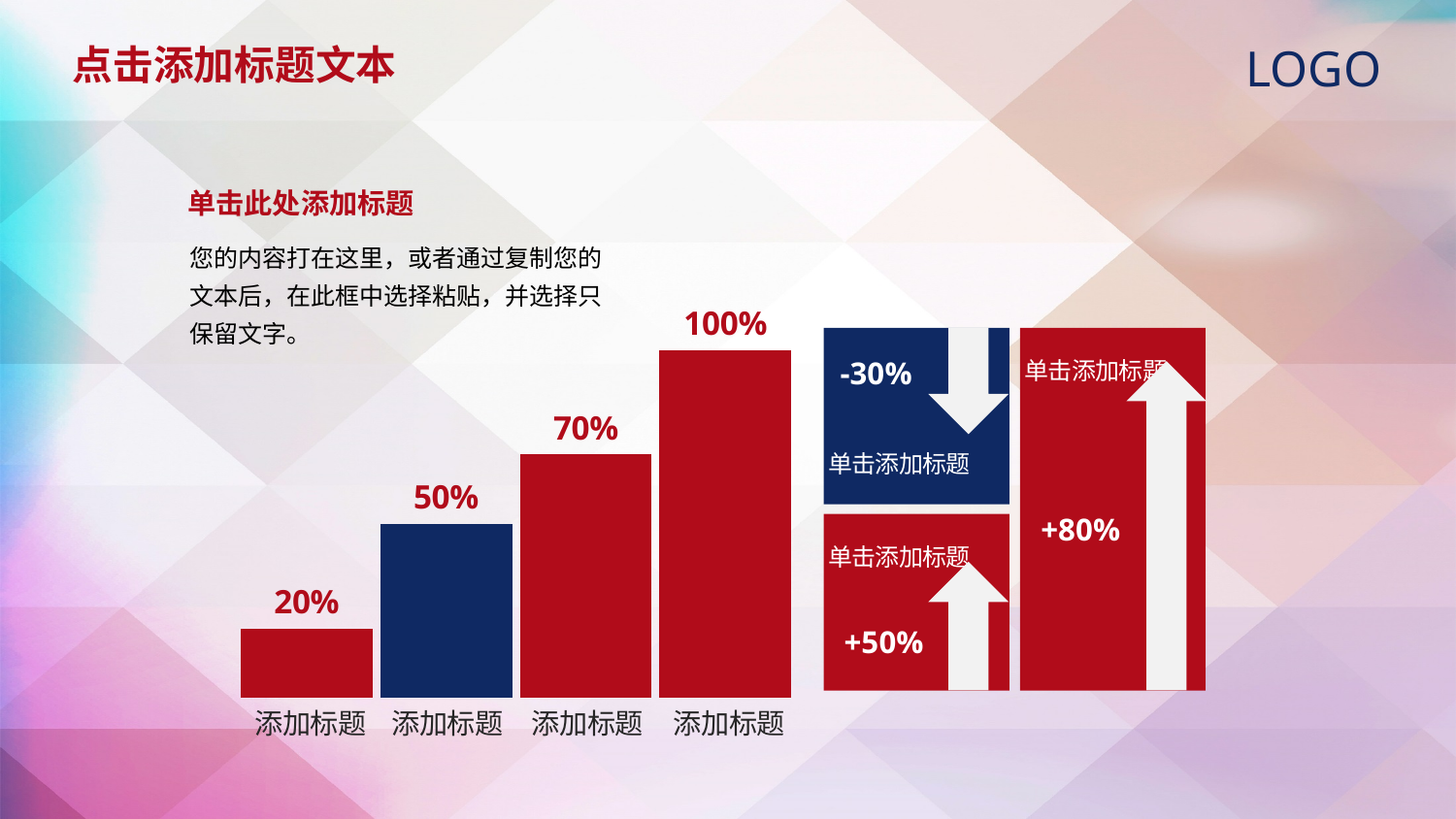
What is the value shown on the second bar of the bar chart? 50% What is the highest value in the bar chart? 100% What type of chart is shown on the slide? bar chart What colour is the second bar in the bar chart? dark blue What is the difference between the fourth bar and the first bar in the bar chart? 80% Which is larger in the bar chart, the second bar or the third bar? the third bar What is the value shown on the third bar of the bar chart? 70% What is the value shown on the fourth (rightmost) bar of the bar chart? 100% What is the lowest value in the bar chart? 20% Do the bar values rise or fall from left to right in the bar chart? rise How many bars does the bar chart have? 4 What is the value shown on the first (leftmost) bar of the bar chart? 20%